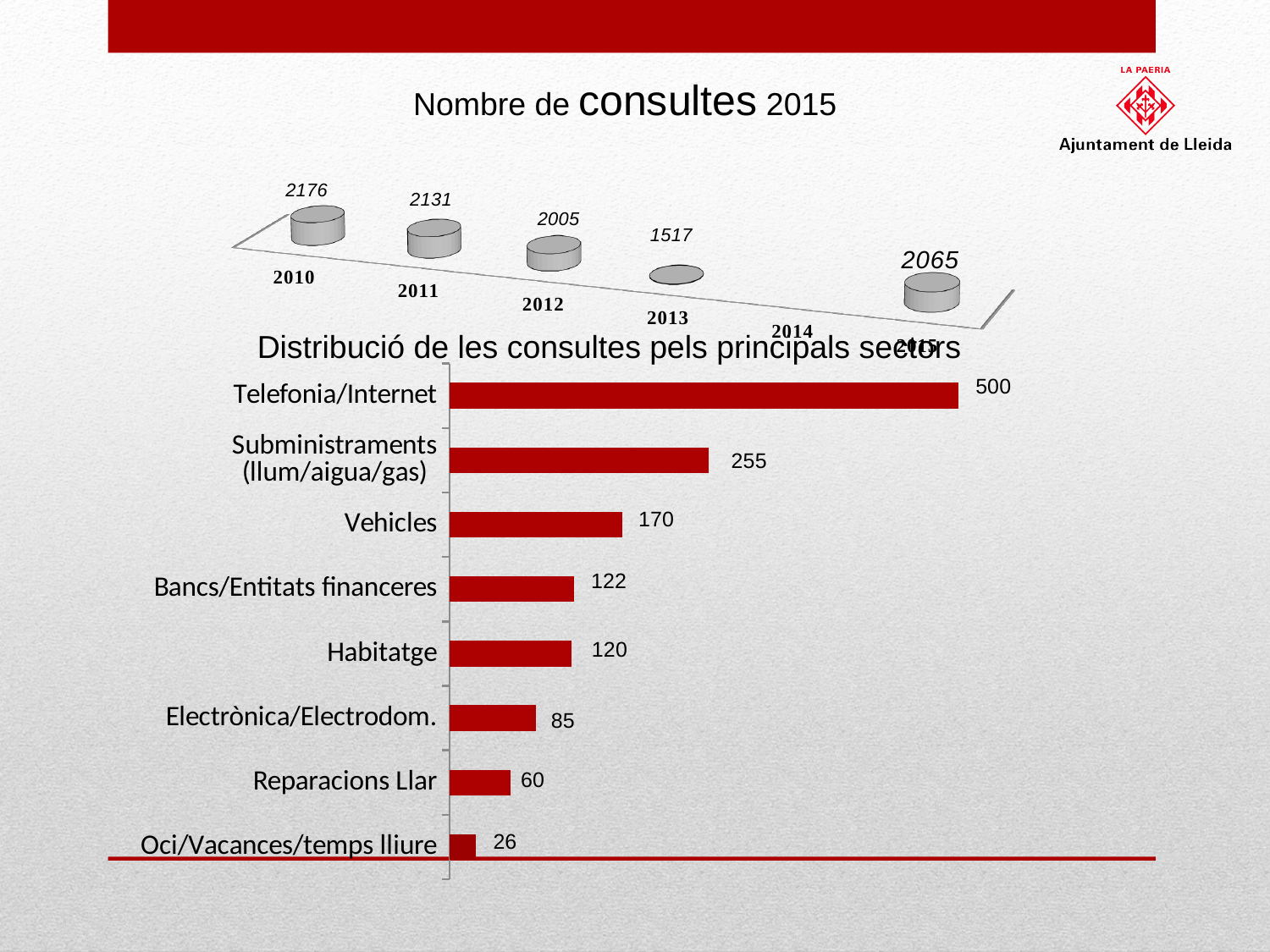
In the bottom chart 'Distribució de les consultes pels principals sectors', which category has the lowest value? Oci/Vacances/temps lliure In the top chart 'Nombre de consultes 2015', what is the value for 2013? 1517 What kind of chart is the bottom chart 'Distribució de les consultes pels principals sectors'? Bar chart In the bottom chart 'Distribució de les consultes pels principals sectors', which is larger, Habitatge or Electrònica/Electrodom.? Habitatge In the bottom chart 'Distribució de les consultes pels principals sectors', what is the value for Telefonia/Internet? 500 In the bottom chart 'Distribució de les consultes pels principals sectors', how many categories are shown? 8 In the bottom chart 'Distribució de les consultes pels principals sectors', what is the value for Vehicles? 170 In the top chart 'Nombre de consultes 2015', what is the value for 2010? 2176 In the top chart 'Nombre de consultes 2015', what is the difference between the 2010 value and the 2013 value? 659 In the bottom chart 'Distribució de les consultes pels principals sectors', what is the value for Reparacions Llar? 60 In the bottom chart 'Distribució de les consultes pels principals sectors', what is the difference between Telefonia/Internet and Subministraments (llum/aigua/gas)? 245 In the bottom chart 'Distribució de les consultes pels principals sectors', which category has the highest value? Telefonia/Internet